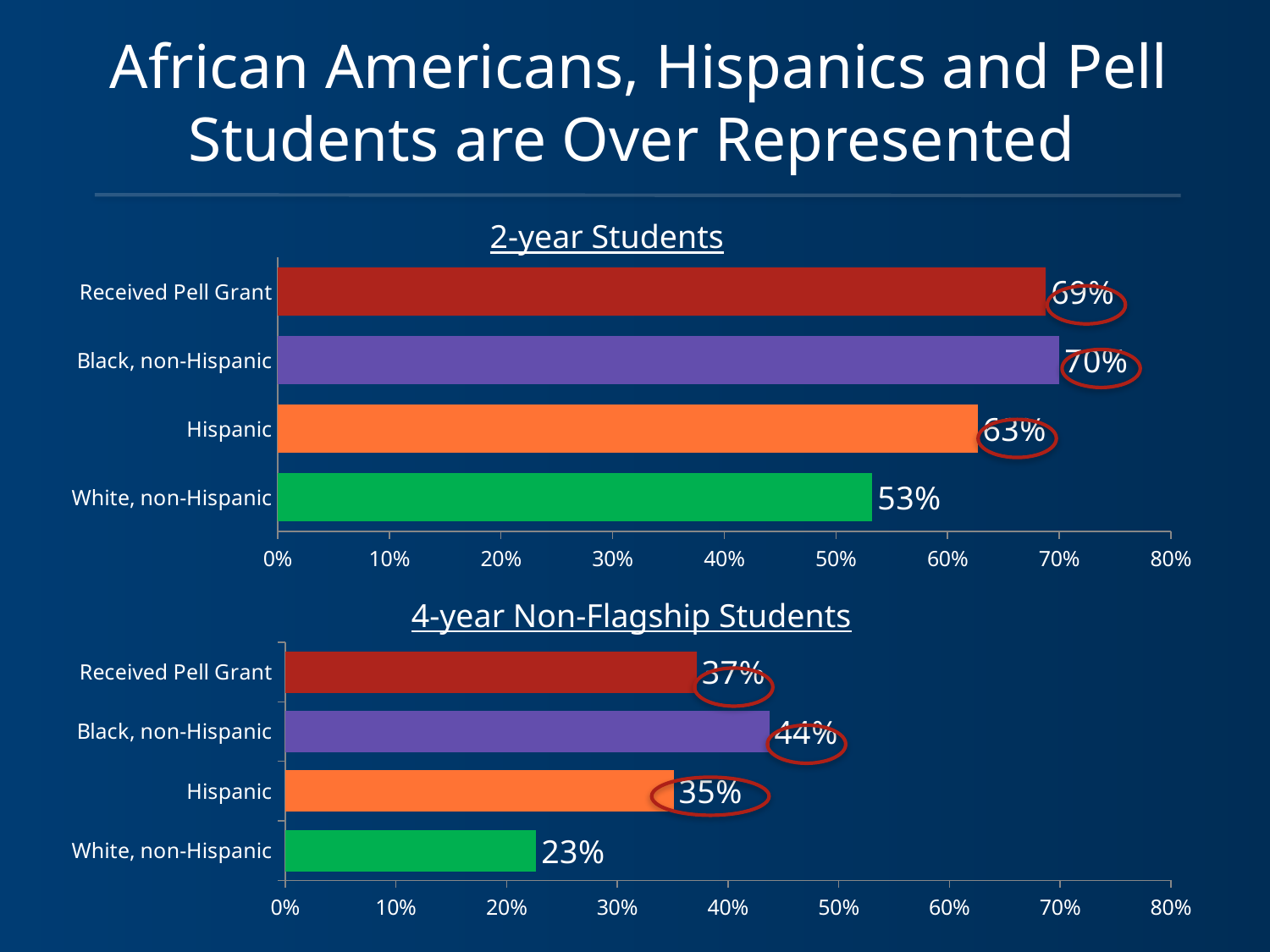
In the 2-year Students chart, is the value for Hispanic greater or less than 60%? greater In the 2-year Students chart, what is the value for Black, non-Hispanic? 70% In the 4-year Non-Flagship Students chart, what is the value for White, non-Hispanic? 23% In the 2-year Students chart, which category has the lowest value? White, non-Hispanic How many categories are shown in the 4-year Non-Flagship Students chart? 4 In the 4-year Non-Flagship Students chart, what is the value for Hispanic? 35% In the 4-year Non-Flagship Students chart, what is the difference between the Black, non-Hispanic value and the White, non-Hispanic value? 21% In the 2-year Students chart, what is the difference between the Hispanic value and the White, non-Hispanic value? 10% What kind of chart is the 2-year Students chart? Bar chart In the 4-year Non-Flagship Students chart, which is larger: the value for Received Pell Grant or the value for Hispanic? Received Pell Grant In the 4-year Non-Flagship Students chart, which category has the highest value? Black, non-Hispanic In the 2-year Students chart, what is the value for White, non-Hispanic? 53%